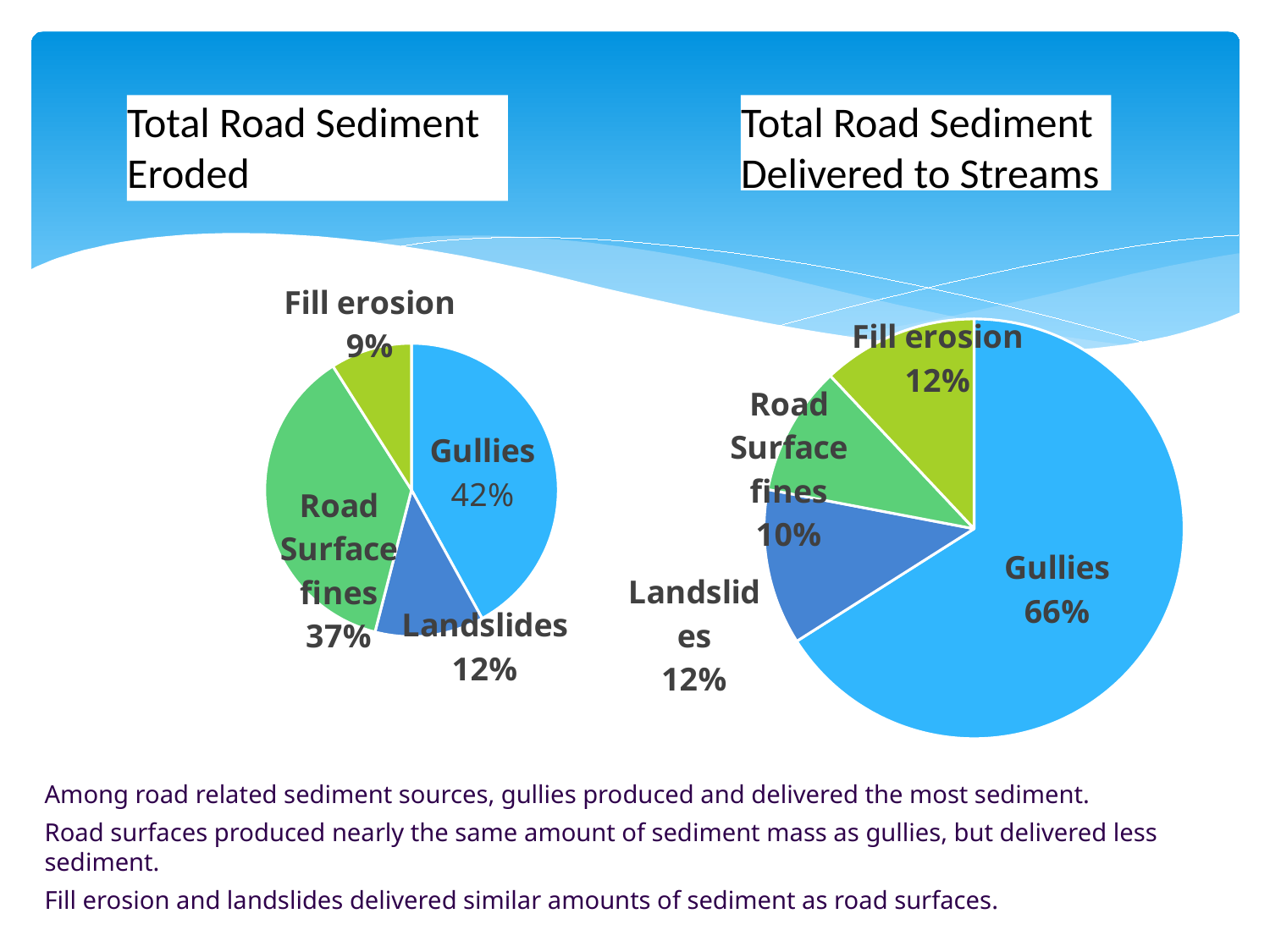
In the 'Total Road Sediment Eroded' chart, what share do Road Surface fines account for? 37% In the 'Total Road Sediment Eroded' chart, which category has the smallest slice? Fill erosion In the 'Total Road Sediment Delivered to Streams' chart, what share does Fill erosion account for? 12% What type of chart is the 'Total Road Sediment Delivered to Streams' chart? Pie chart How many categories does the 'Total Road Sediment Eroded' chart show? 4 In the 'Total Road Sediment Eroded' chart, which is larger: the Landslides share or the Fill erosion share? Landslides In the 'Total Road Sediment Delivered to Streams' chart, which category has the largest slice? Gullies In the 'Total Road Sediment Eroded' chart, what share do Gullies account for? 42% In the 'Total Road Sediment Delivered to Streams' chart, what is the difference between the Gullies share and the Landslides share? 54% In the 'Total Road Sediment Eroded' chart, what is the difference between the Gullies share and the Road Surface fines share? 5% In the 'Total Road Sediment Delivered to Streams' chart, what share do Gullies account for? 66% In the 'Total Road Sediment Delivered to Streams' chart, which category has the smallest slice? Road Surface fines